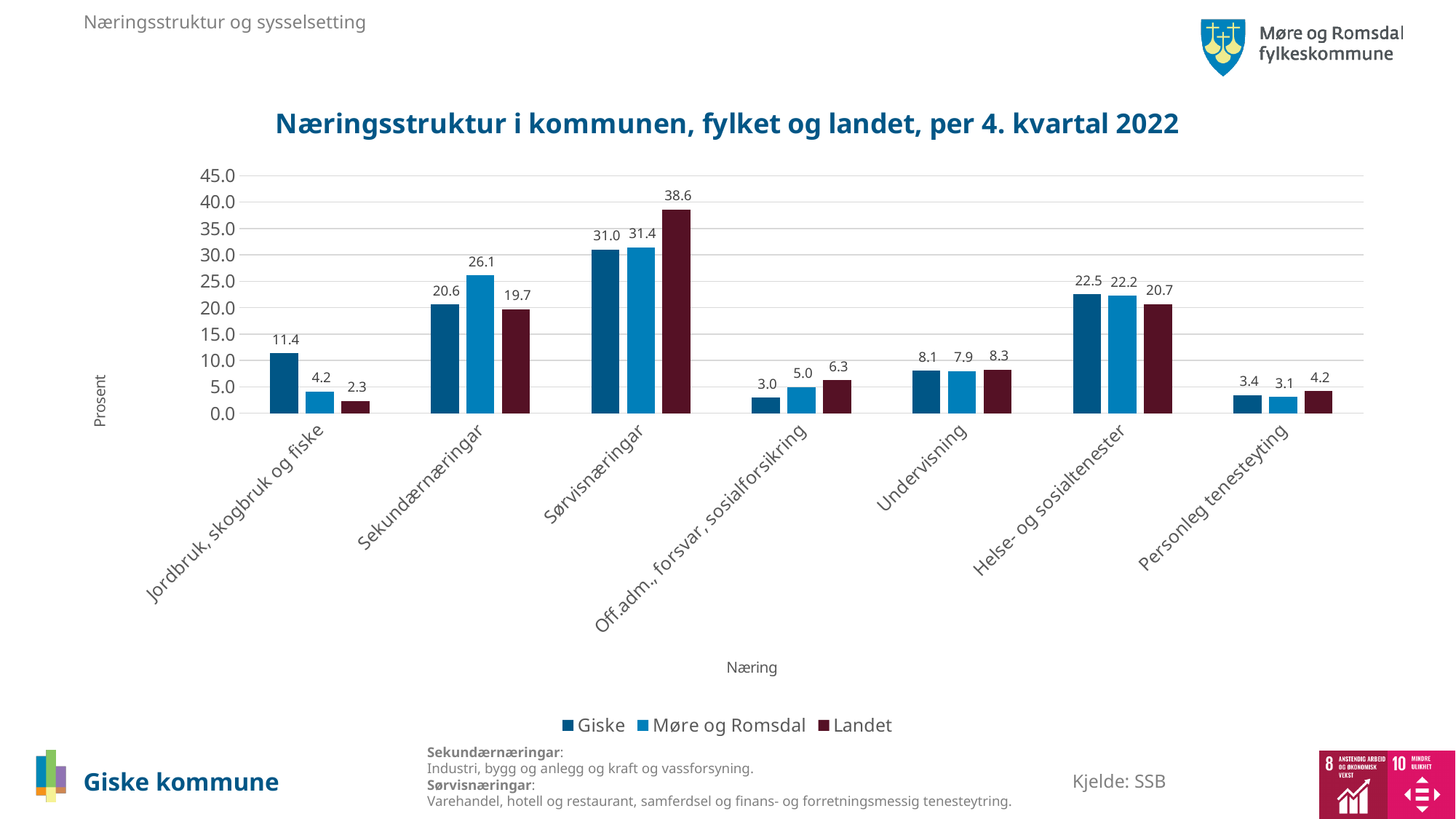
How many categories are shown on the x axis? 7 What is the value for Giske in Jordbruk, skogbruk og fiske? 11.4 What kind of chart is shown? bar chart What is the value for Møre og Romsdal in Sekundærnæringar? 26.1 What is the difference between the Landet and Giske values in Sørvisnæringar? 7.6 Which category has the lowest value for Landet? Jordbruk, skogbruk og fiske Which is larger in Jordbruk, skogbruk og fiske: Giske or Møre og Romsdal? Giske What is the title of the chart? Næringsstruktur i kommunen, fylket og landet, per 4. kvartal 2022 What is the value for Landet in Sørvisnæringar? 38.6 Is the value for Møre og Romsdal in Sekundærnæringar greater or less than 25.0? greater How many series does the legend list? 3 Which category has the highest value for Giske? Sørvisnæringar